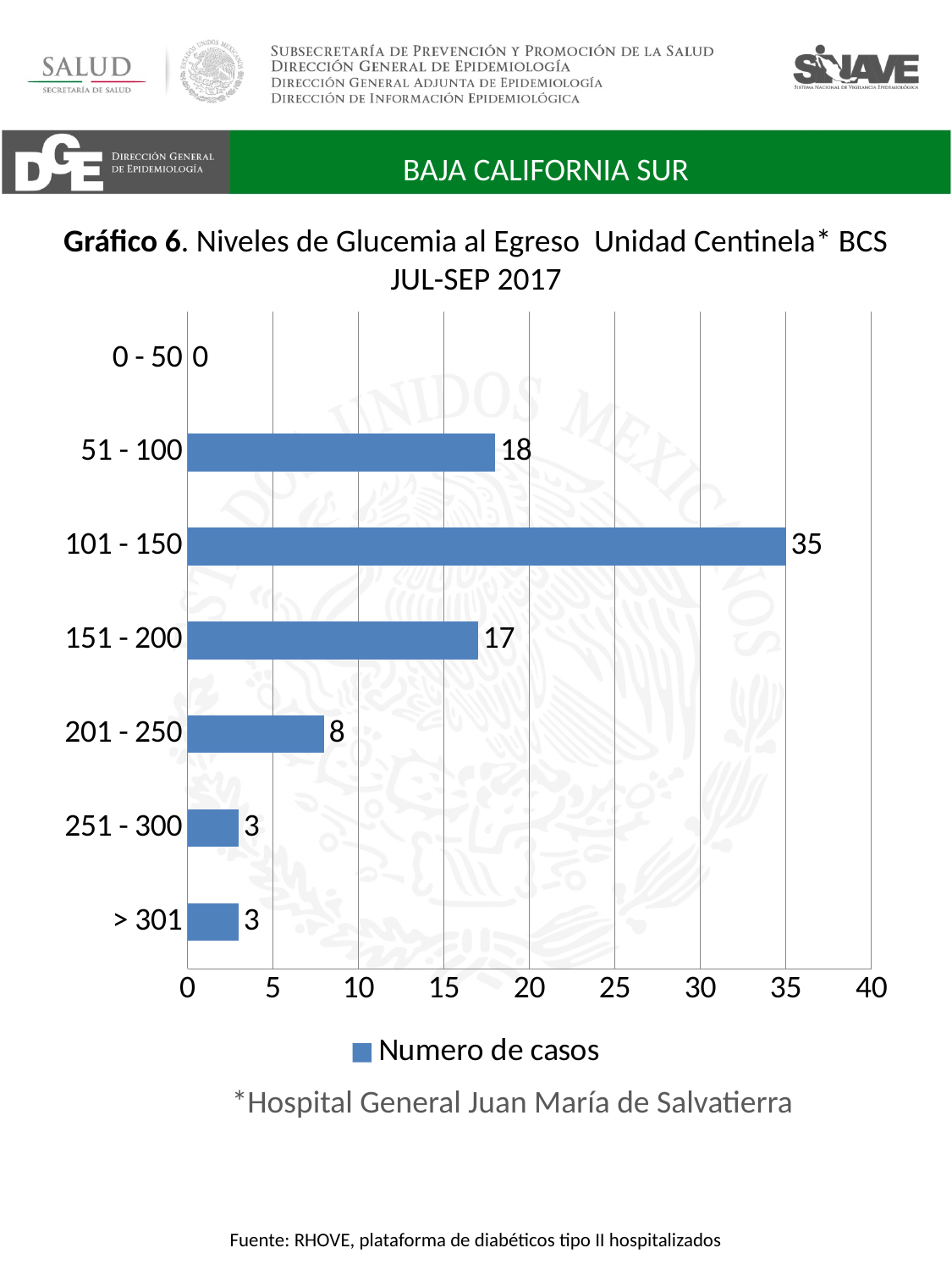
What is the number of cases for the 101 - 150 glucose level category? 35 Which category has more cases, 51 - 100 or 151 - 200? 51 - 100 What is the total number of cases across the 251 - 300 and > 301 categories? 6 How many series does the legend list? 1 What is the number of cases for the 201 - 250 category? 8 Which glucose level category has the highest number of cases? 101 - 150 What is the number of cases for the 51 - 100 category? 18 Which glucose level category has the lowest number of cases? 0 - 50 How many glucose level categories are shown on the chart? 7 What kind of chart is shown on the slide? Bar chart What is the difference in number of cases between the 101 - 150 and 151 - 200 categories? 18 What is the name of the series shown in the legend? Numero de casos